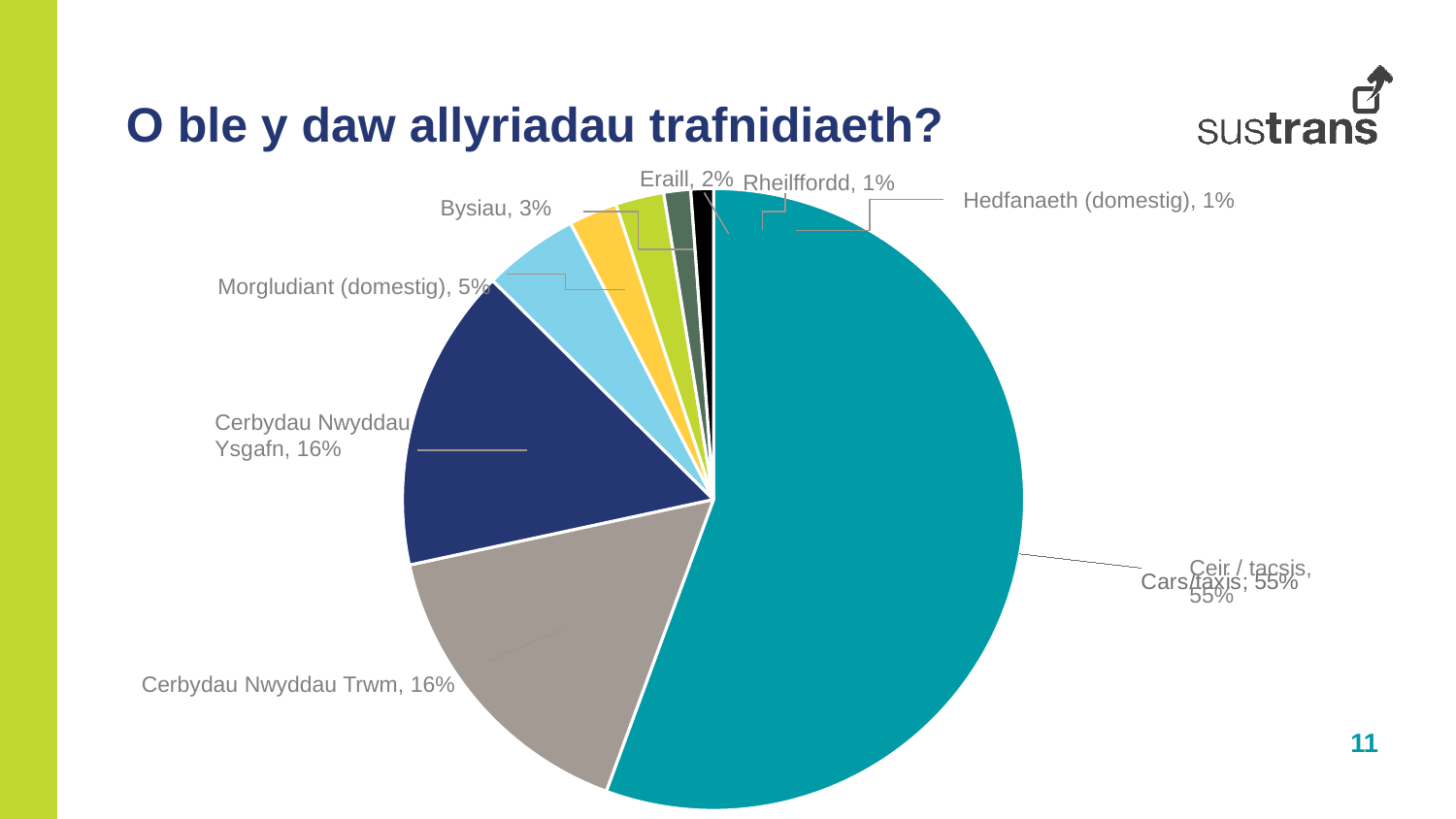
What is the value shown for Bysiau? 3% What is the title of the slide containing the pie chart? O ble y daw allyriadau trafnidiaeth? How many slices does the pie chart have? 8 What is the value shown for Eraill? 2% Which is larger, the share for Morgludiant (domestig) or the share for Bysiau? Morgludiant (domestig) What is the value shown for Morgludiant (domestig)? 5% What is the value shown for Cerbydau Nwyddau Trwm? 16% What is the value shown for Rheilffordd? 1% What kind of chart is shown on the slide? pie chart What share of transport emissions comes from Ceir / tacsis? 55% What is the difference between the share for Ceir / tacsis and the share for Cerbydau Nwyddau Ysgafn? 39% Which category has the largest slice of the pie? Ceir / tacsis